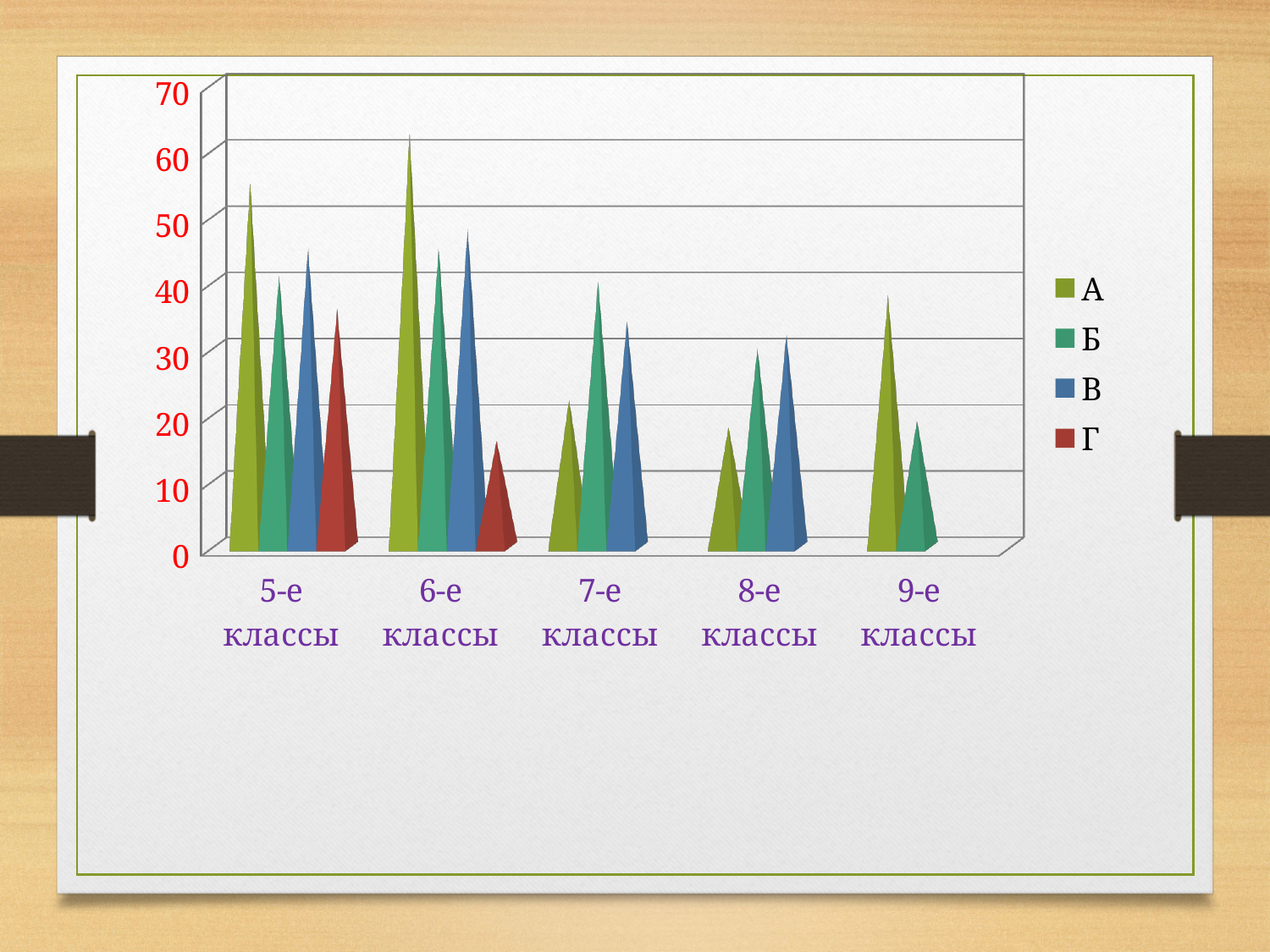
Is the value for series Б in 7-е классы greater or less than 30? greater Is the value for series А in 6-е классы greater or less than 50? greater Which category has the highest value for series А? 6-е классы Is the value for series А in 8-е классы greater or less than 30? less In 6-е классы, which is larger: series Б or series Г? Б How many categories are shown on the x axis? 5 In 5-е классы, which is larger: series А or series Г? А What kind of chart is shown on the slide? bar chart In 9-е классы, which is larger: series А or series Б? А What are the entries listed in the legend? А, Б, В, Г How many series does the legend list? 4